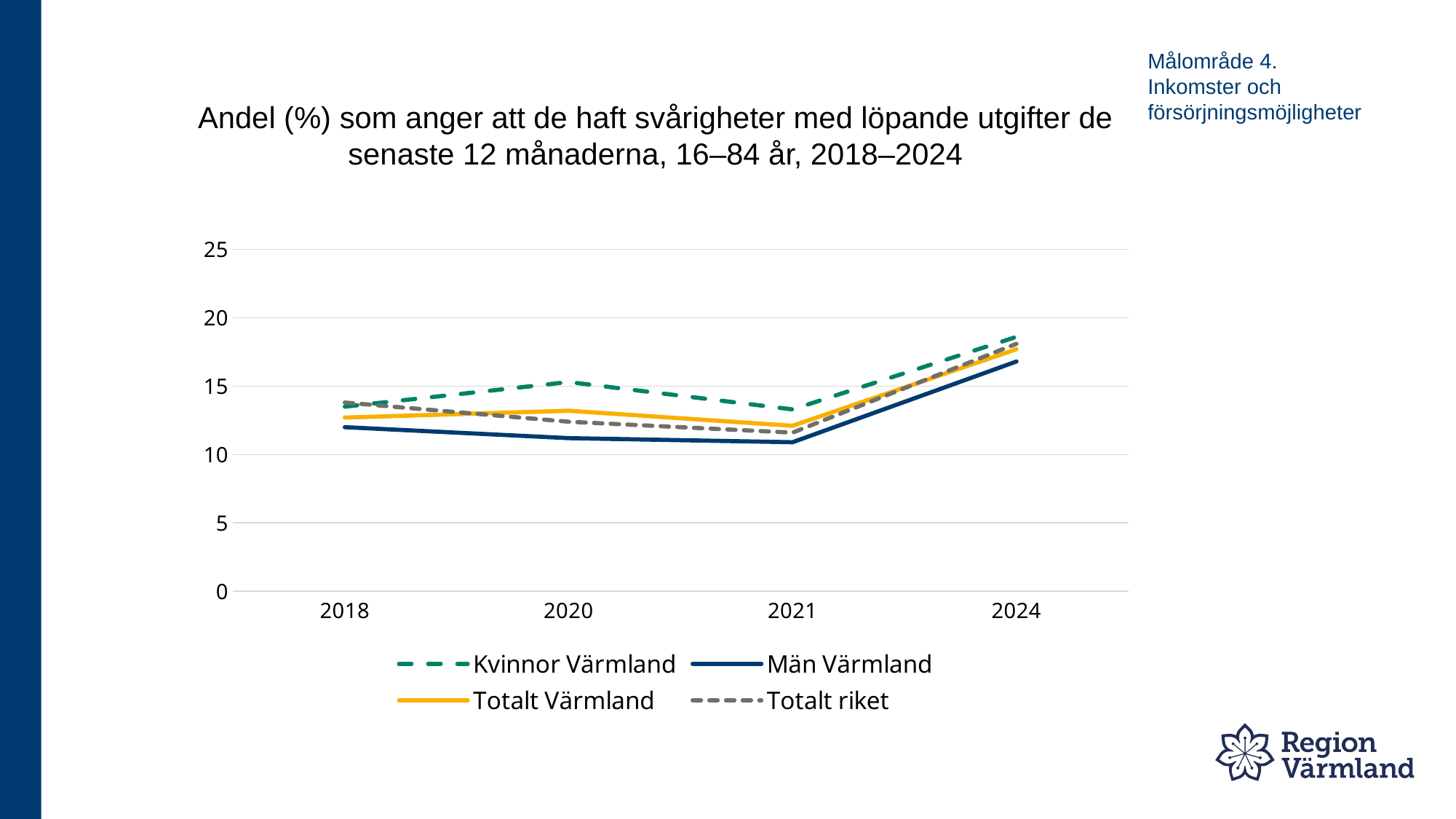
What kind of chart is shown on the slide? line chart Which series has the lowest value in 2024? Män Värmland Which series has the highest value in 2020? Kvinnor Värmland Which series is drawn with a solid yellow line? Totalt Värmland Is the value for Totalt Värmland in 2020 greater or less than 10? greater Is the value for Kvinnor Värmland in 2024 greater or less than 15? greater Do the values for Män Värmland rise or fall between 2021 and 2024? rise How many series does the legend list? 4 How many years are shown on the x axis? 4 Is the value for Män Värmland in 2021 greater or less than 15? less In 2021, which is larger: the value for Kvinnor Värmland or the value for Män Värmland? Kvinnor Värmland